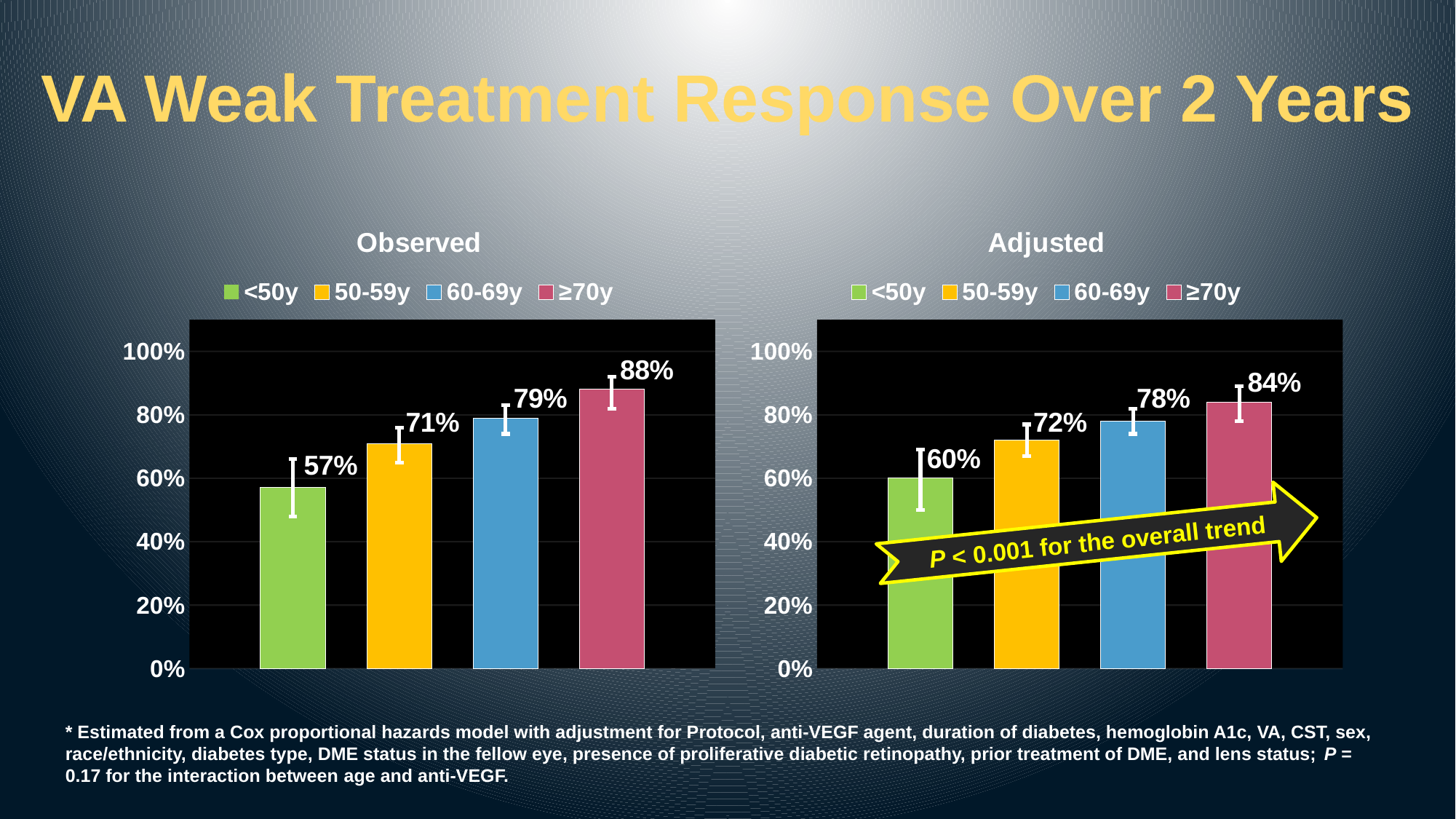
In the Observed chart, what is the difference between the ≥70y value and the <50y value? 31% How many entries does the legend of the Adjusted chart list? 4 In the Observed chart, what is the value for the <50y group? 57% In the Adjusted chart, do the values rise or fall as age group increases from <50y to ≥70y? rise How many age groups are plotted in the Observed chart? 4 In the Adjusted chart, what is the value for the 60-69y group? 78% In the Adjusted chart, is the value for ≥70y greater or less than 80%? greater In the Observed chart, which is larger, the value for 50-59y or the value for 60-69y? 60-69y In the Adjusted chart, what is the difference between the 50-59y value and the <50y value? 12% In the Adjusted chart, which age group has the lowest value? <50y What kind of chart is the Observed chart? bar chart In the Observed chart, which age group has the highest value? ≥70y